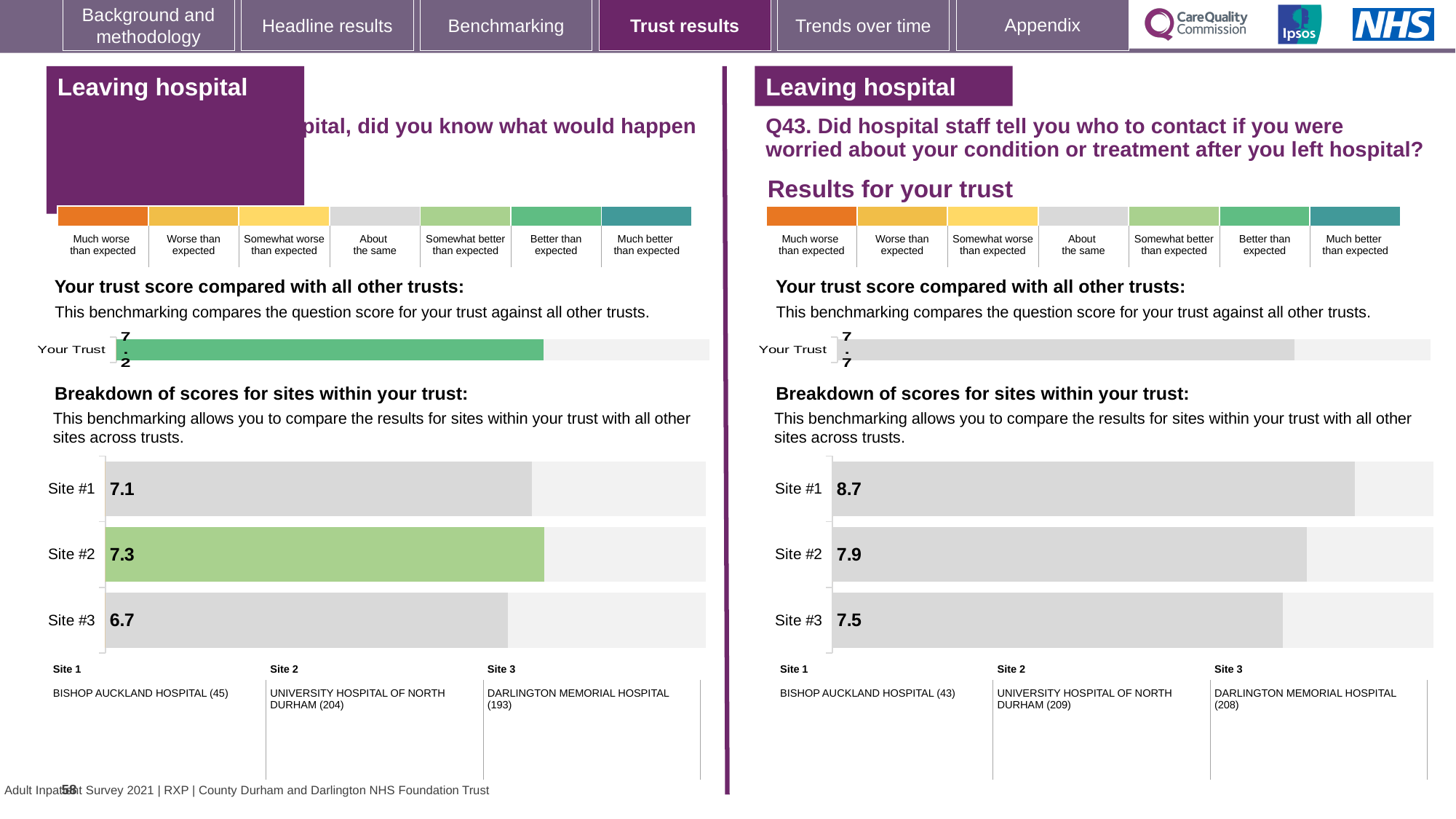
On the right-hand chart (Q43), what is the score for Site #3? 7.5 On the right-hand chart (Q43), which site has the highest score? Site #1 On the right-hand chart (Q43), what is the score for Site #1? 8.7 What type of chart is used for the site breakdown on the right-hand side (Q43)? Bar chart How many sites are shown in the right-hand (Q43) site breakdown chart? 3 On the left-hand site breakdown chart, which site has the lowest score? Site #3 On the left-hand site breakdown chart, which has the higher score, Site #1 or Site #2? Site #2 On the right-hand chart (Q43), what is the 'Your Trust' score shown in the trust comparison bar? 7.7 On the left-hand site breakdown chart, what is the score for Site #2? 7.3 On the right-hand chart (Q43), what is the difference between the scores for Site #1 and Site #3? 1.2 On the left-hand site breakdown chart, what is the score for Site #3? 6.7 On the left-hand site breakdown chart, what is the difference between the scores for Site #2 and Site #3? 0.6